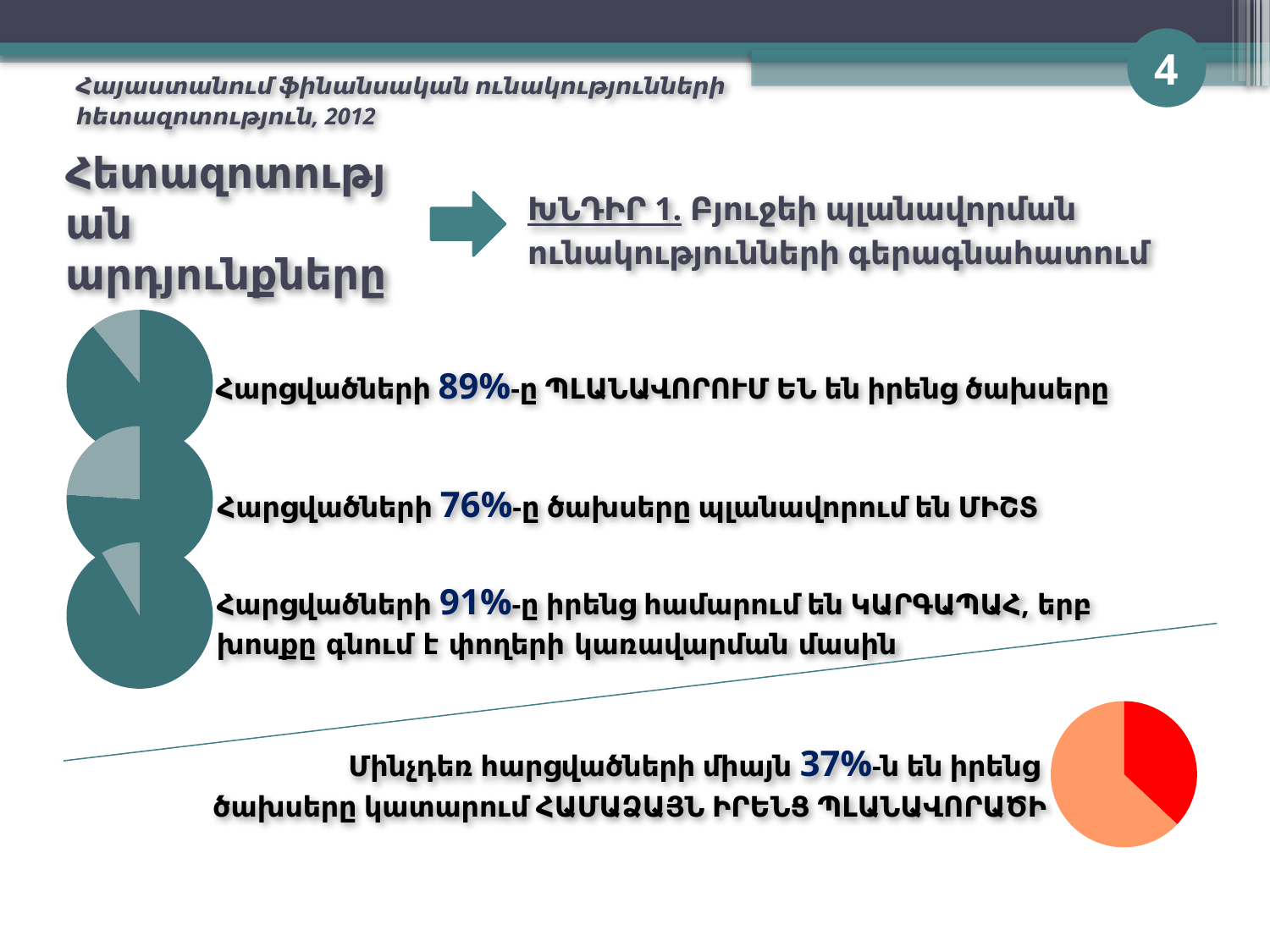
What percentage is printed next to the second pie chart on the left? 76% What is the difference between the percentage next to the top-left pie chart (89%) and the percentage next to the second pie chart (76%)? 13 percentage points What percentage is printed next to the red and orange pie chart at the bottom right? 37% Which of the four percentages shown next to the pie charts is the highest? 91% How many pie charts are on the slide? 4 Which is larger: the percentage next to the second pie chart on the left or the percentage next to the bottom-right pie chart? the second pie chart on the left (76%) What percentage is printed next to the top pie chart on the left? 89% What percentage is printed next to the third pie chart on the left? 91% What kind of chart is shown next to the statement about 89% of respondents? pie chart Which of the four percentages shown next to the pie charts is the lowest? 37% What is the difference between the percentage next to the third pie chart (91%) and the percentage next to the bottom-right pie chart (37%)? 54 percentage points What two colours are used in the pie chart at the bottom right of the slide? red and orange